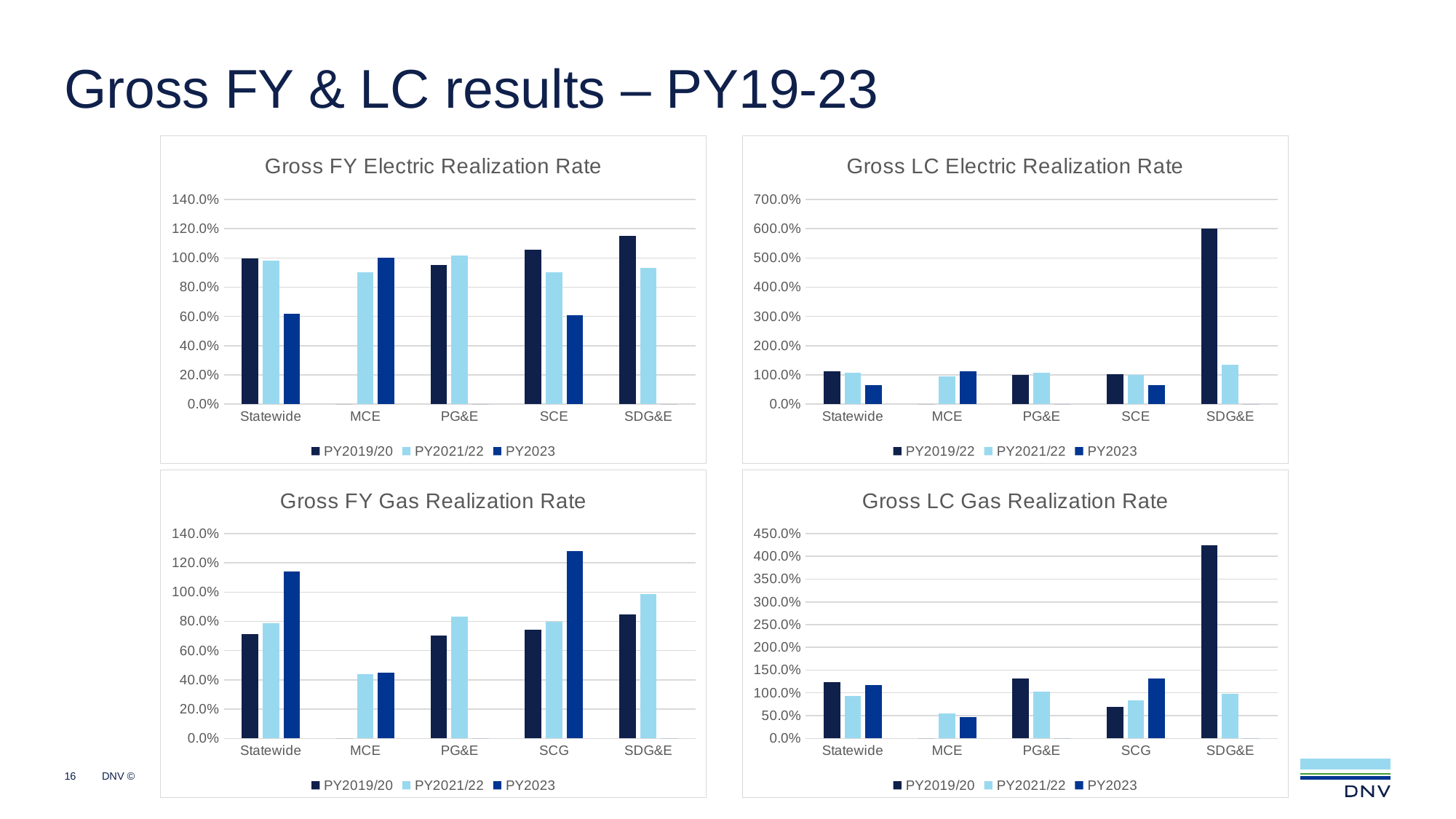
In the Gross FY Gas Realization Rate chart, how many categories are shown on the x axis? 5 In the Gross LC Gas Realization Rate chart, which category has the highest PY2019/20 value? SDG&E In the Gross FY Electric Realization Rate chart, which is larger: the PY2019/20 value for SDG&E or the PY2019/20 value for SCE? SDG&E In the Gross LC Electric Realization Rate chart, is the PY2019/22 value for SDG&E greater or less than 500.0%? greater In the Gross FY Gas Realization Rate chart, which is larger: the PY2023 value for Statewide or the PY2023 value for MCE? Statewide How many series does the legend of the Gross LC Electric Realization Rate chart list? 3 In the Gross FY Gas Realization Rate chart, is the PY2023 value for SCG greater or less than 120.0%? greater What is the first series listed in the legend of the Gross LC Electric Realization Rate chart? PY2019/22 What kind of chart is the Gross FY Electric Realization Rate chart? bar chart In the Gross LC Electric Realization Rate chart, which category has the highest PY2019/22 value? SDG&E In the Gross FY Electric Realization Rate chart, is the PY2023 value for Statewide greater or less than 80.0%? less In the Gross FY Gas Realization Rate chart, which category has the lowest PY2021/22 value? MCE